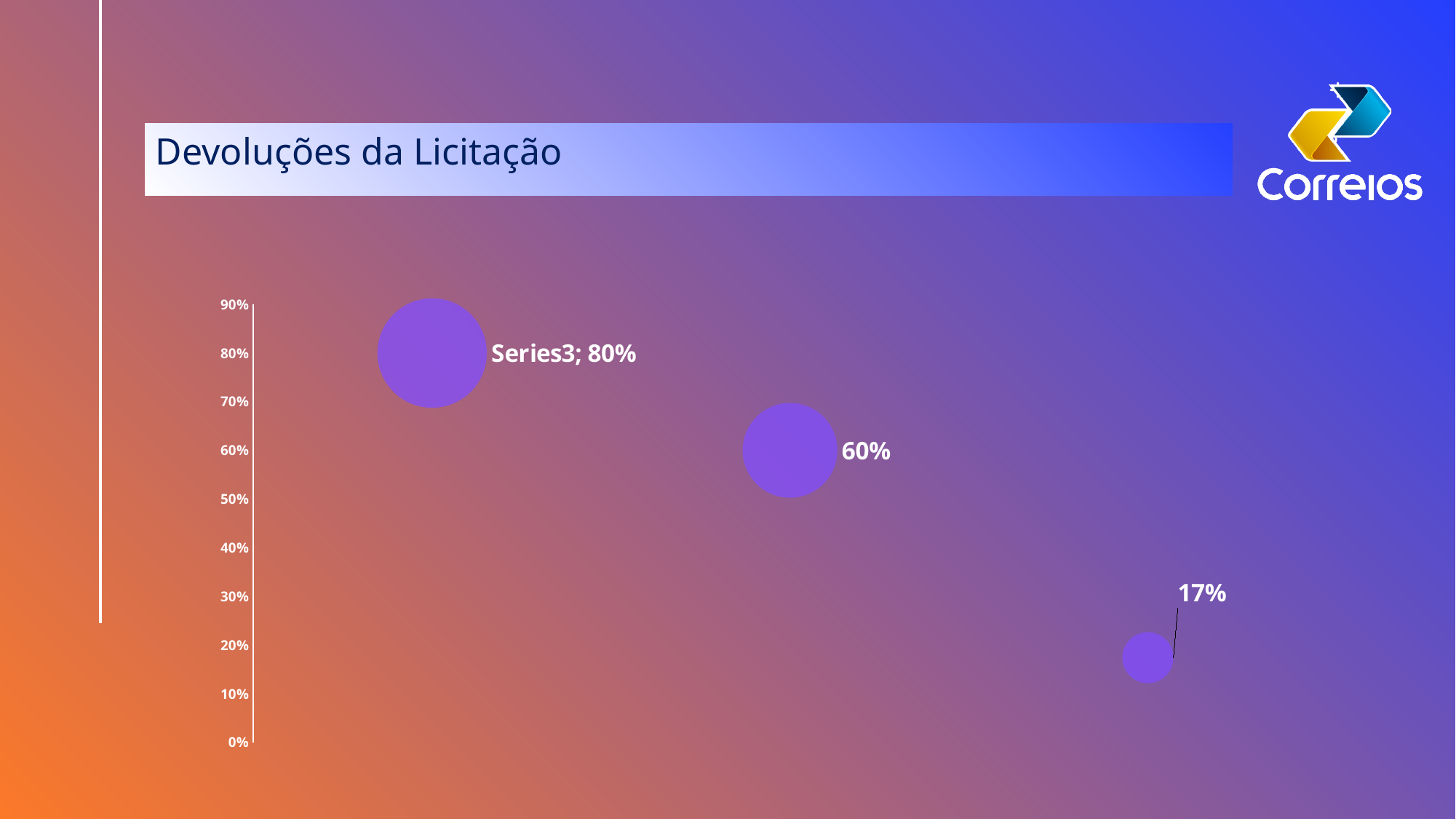
What value is labelled for Series3? 80% Do the bubble values rise or fall from left to right across the chart? fall What value is labelled on the rightmost (smallest) bubble? 17% How many bubbles are plotted on the chart? 3 What is the difference between the highest labelled value and the lowest labelled value? 63 percentage points What is the title of the chart on the slide? Devoluções da Licitação What kind of chart is shown on the slide? bubble chart What is the difference between the Series3 value (80%) and the middle bubble's value (60%)? 20 percentage points What is the lowest value labelled on the chart? 17% Which is larger, the value of the middle bubble or the value of the rightmost bubble? the middle bubble (60%) What is the highest value labelled on the chart? 80% What value is labelled on the middle bubble? 60%